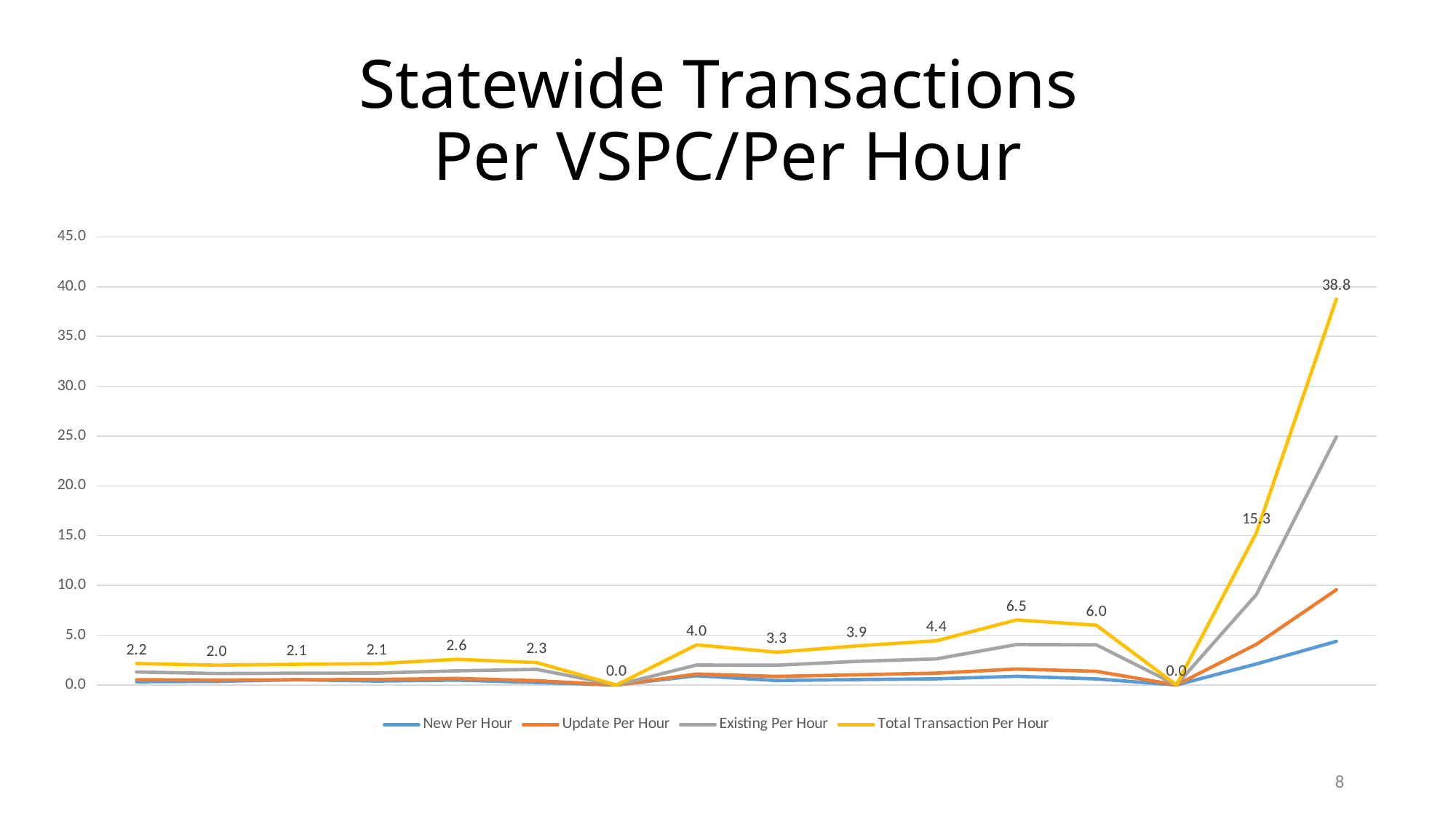
What is the value of the Total Transaction Per Hour series at the first point on the x axis? 2.2 Which is larger for the Total Transaction Per Hour series: the value labelled 6.5 or the value labelled 4.4? 6.5 Is the value of the Existing Per Hour series at the last point on the x axis greater or less than 20.0? greater What is the value of the Total Transaction Per Hour series at the second-to-last point on the x axis? 15.3 What is the lowest labelled value of the Total Transaction Per Hour series? 0.0 How many data points are plotted along the x axis for the Total Transaction Per Hour series? 16 Which colour is used for the Total Transaction Per Hour series? yellow What is the difference between the last two labelled values of the Total Transaction Per Hour series (38.8 and 15.3)? 23.5 How many series does the legend list? 4 Does the Total Transaction Per Hour series rise or fall over its last three points on the x axis? rise What is the highest labelled value of the Total Transaction Per Hour series? 38.8 What kind of chart is shown on the slide? line chart